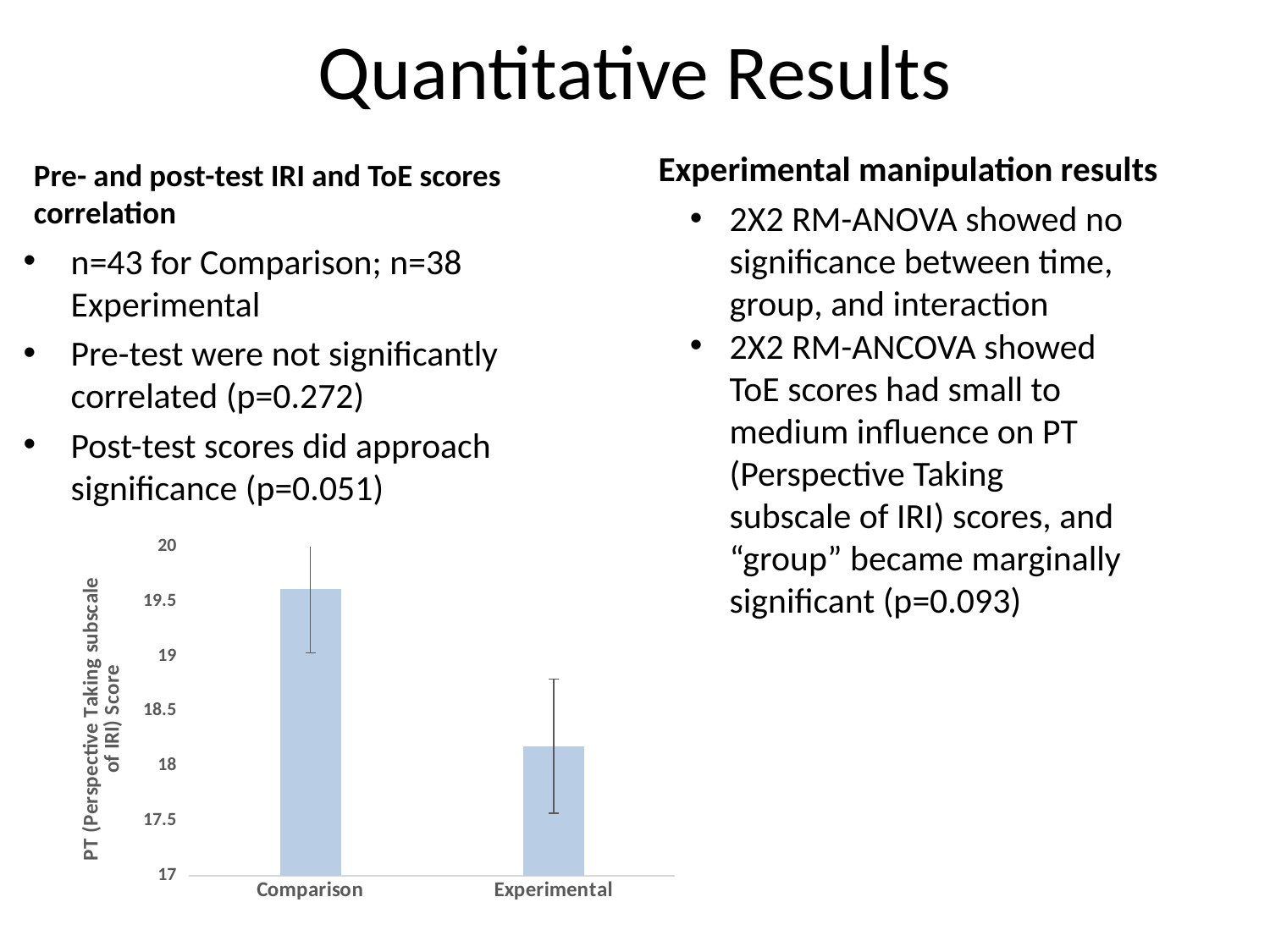
Is the value for Comparison greater or less than 20? less What kind of chart is shown on the slide? Bar chart What is the label on the vertical axis of the bar chart? PT (Perspective Taking subscale of IRI) Score Which category has the highest PT score in the bar chart? Comparison Is the value for Experimental greater or less than 19? less Which category has the lowest PT score in the bar chart? Experimental Which group has the larger PT score, Comparison or Experimental? Comparison Is the value for Experimental greater or less than 18.5? less How many categories are plotted on the bar chart? 2 What is the lowest value shown on the vertical axis of the bar chart? 17